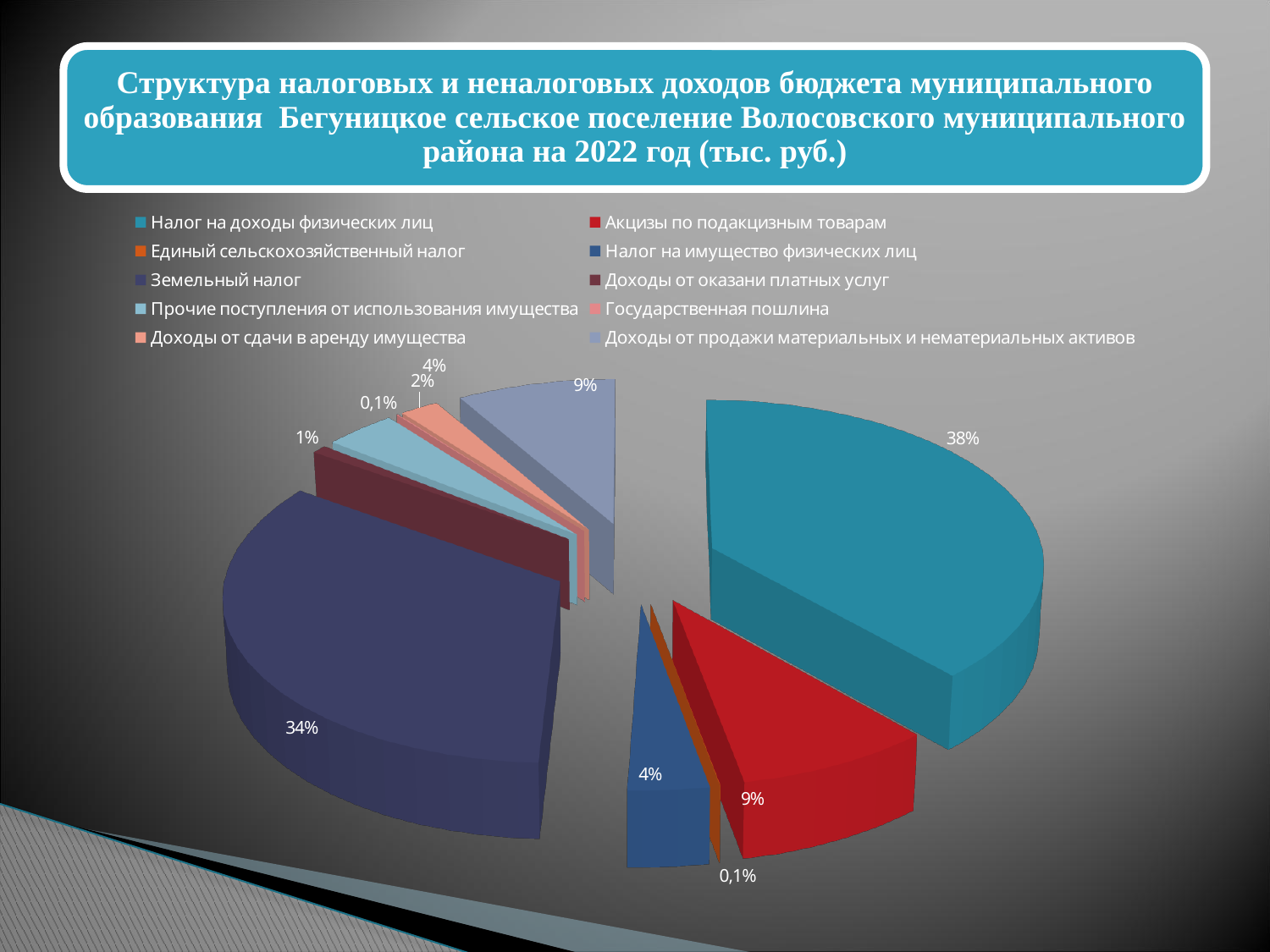
What share of the pie does Земельный налог have? 34% For which year does the chart title say the budget revenue structure is shown? 2022 What share of the pie does Акцизы по подакцизным товарам have? 9% What share of the pie does Доходы от оказани платных услуг have? 1% What share of the pie does Государственная пошлина have? 0,1% Which is larger: the share for Налог на доходы физических лиц or the share for Земельный налог? Налог на доходы физических лиц How many categories does the legend list? 10 What share of the pie does Единый сельскохозяйственный налог have? 0,1% Which category has the largest share of the pie? Налог на доходы физических лиц What is the difference in percentage points between the share for Налог на доходы физических лиц and the share for Земельный налог? 4 What share of the pie does Налог на доходы физических лиц have? 38% What kind of chart is shown on the slide? pie chart